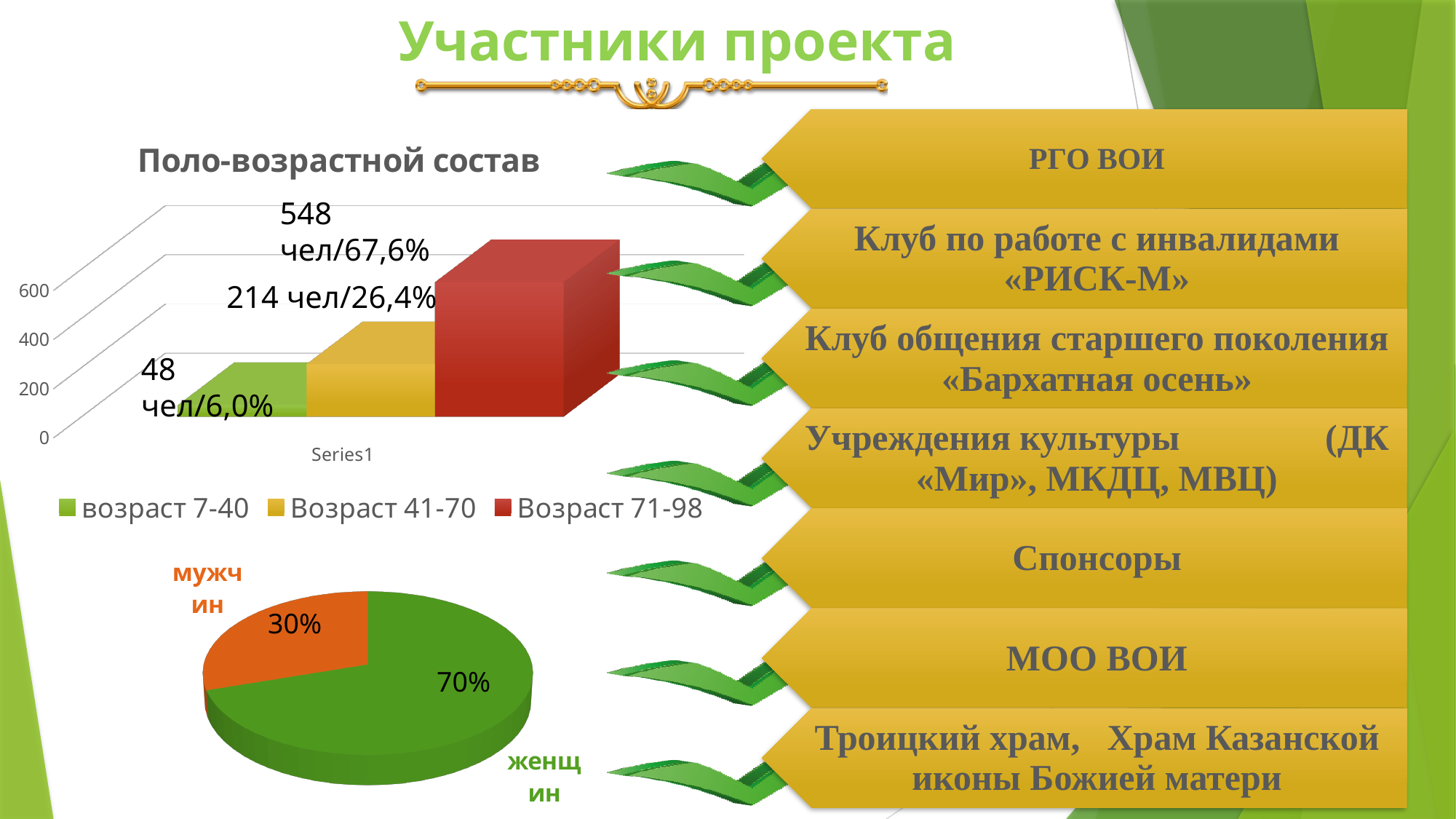
In the pie chart at the bottom left, which slice is larger, "мужчин" or "женщин"? женщин In the chart titled "Поло-возрастной состав", how many more people are in the group "Возраст 71-98" than in "Возраст 41-70"? 334 In the chart titled "Поло-возрастной состав", what is the data label for the series "возраст 7-40"? 48 чел/6,0% In the pie chart at the bottom left, what share is labelled "женщин"? 70% In the chart titled "Поло-возрастной состав", how many series does the legend list? 3 In the pie chart at the bottom left, what share is labelled "мужчин"? 30% In the chart titled "Поло-возрастной состав", what is the data label for the series "Возраст 71-98"? 548 чел/67,6% In the chart titled "Поло-возрастной состав", is the value for "Возраст 71-98" greater or less than 400? greater In the chart titled "Поло-возрастной состав", which age group has the lowest value? возраст 7-40 In the chart titled "Поло-возрастной состав", what kind of chart is it? bar chart In the chart titled "Поло-возрастной состав", what is the data label for the series "Возраст 41-70"? 214 чел/26,4% In the chart titled "Поло-возрастной состав", which age group has the highest value? Возраст 71-98